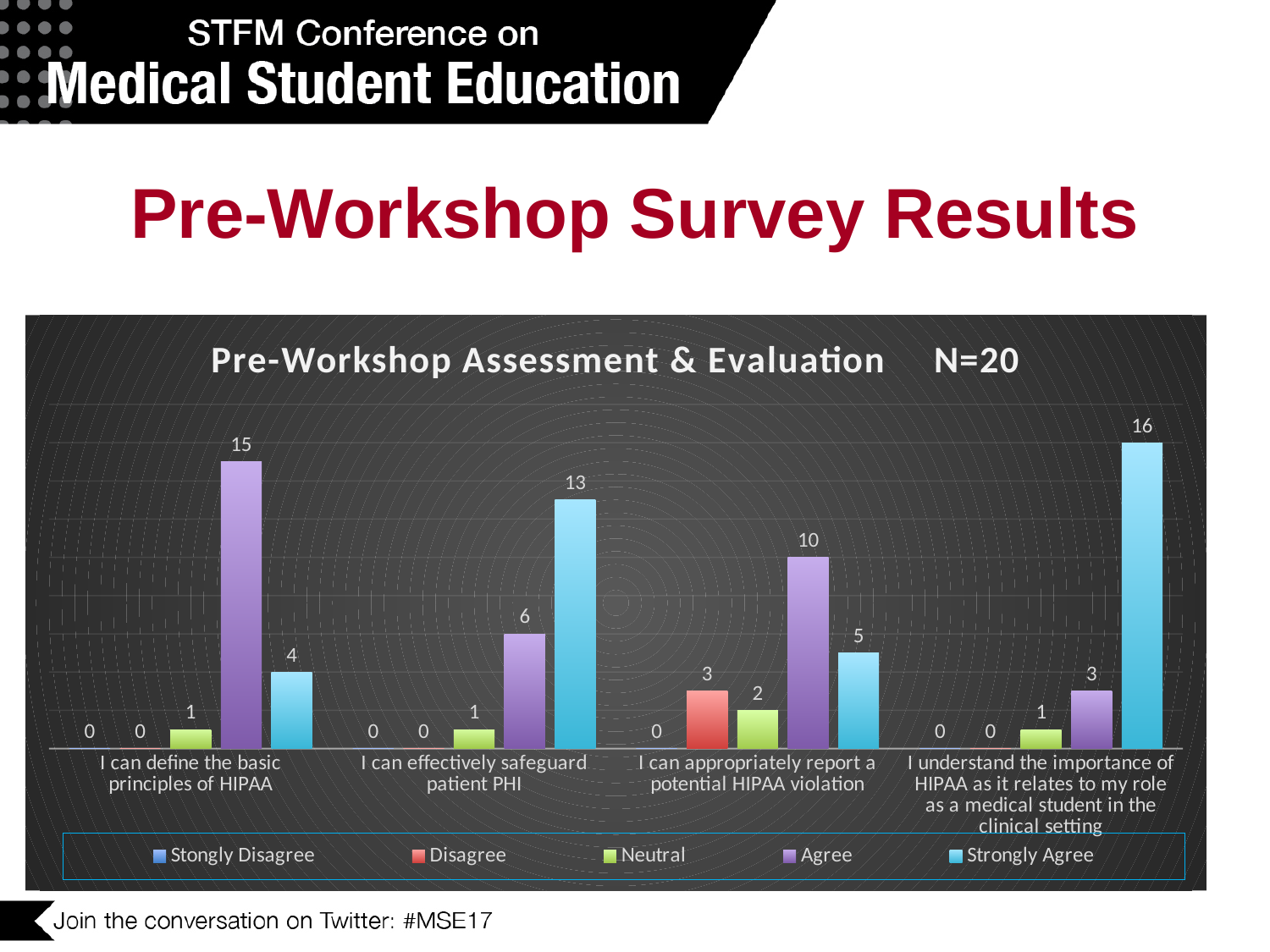
What kind of chart is shown? Bar chart What is the difference between the Agree and Strongly Agree values in the category "I can define the basic principles of HIPAA"? 11 Which category has the lowest Agree value? I understand the importance of HIPAA as it relates to my role as a medical student in the clinical setting In the category "I can appropriately report a potential HIPAA violation", which is larger, Agree or Strongly Agree? Agree What is the value for Disagree in the category "I can appropriately report a potential HIPAA violation"? 3 What is the N value shown in the chart title? N=20 How many series does the legend list? 5 How many categories are shown on the x axis? 4 What is the value for Strongly Agree in the category "I understand the importance of HIPAA as it relates to my role as a medical student in the clinical setting"? 16 Which category has the highest Strongly Agree value? I understand the importance of HIPAA as it relates to my role as a medical student in the clinical setting What is the value for Strongly Agree in the category "I can effectively safeguard patient PHI"? 13 What is the value for Agree in the category "I can define the basic principles of HIPAA"? 15